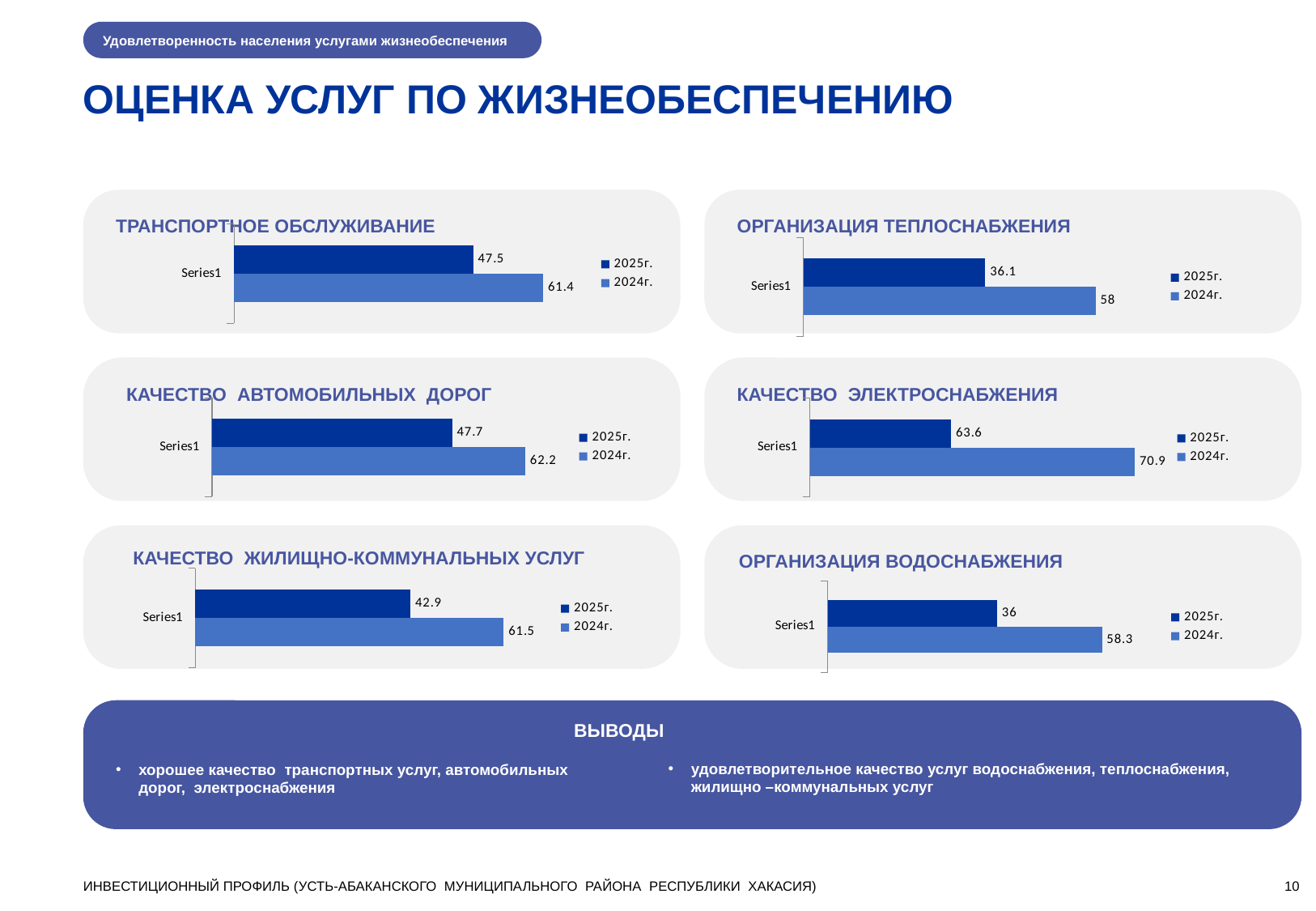
In the chart titled «КАЧЕСТВО ЭЛЕКТРОСНАБЖЕНИЯ», what is the value for 2024г.? 70.9 How many charts are shown on the slide? 6 In the chart titled «КАЧЕСТВО ЖИЛИЩНО-КОММУНАЛЬНЫХ УСЛУГ», which series has the larger value, 2025г. or 2024г.? 2024г. In the chart titled «ОРГАНИЗАЦИЯ ВОДОСНАБЖЕНИЯ», what is the difference between the 2024г. and 2025г. values? 22.3 In the chart titled «ТРАНСПОРТНОЕ ОБСЛУЖИВАНИЕ», what is the value for 2024г.? 61.4 In the chart titled «ОРГАНИЗАЦИЯ ВОДОСНАБЖЕНИЯ», what is the value for 2024г.? 58.3 In the chart titled «ОРГАНИЗАЦИЯ ТЕПЛОСНАБЖЕНИЯ», what is the difference between the 2024г. and 2025г. values? 21.9 In the chart titled «ТРАНСПОРТНОЕ ОБСЛУЖИВАНИЕ», what is the value for 2025г.? 47.5 How many series does the legend list in the chart titled «ОРГАНИЗАЦИЯ ТЕПЛОСНАБЖЕНИЯ»? 2 In the chart titled «ОРГАНИЗАЦИЯ ТЕПЛОСНАБЖЕНИЯ», what is the value for 2025г.? 36.1 In the chart titled «КАЧЕСТВО АВТОМОБИЛЬНЫХ ДОРОГ», what is the difference between the 2024г. and 2025г. values? 14.5 What kind of chart is the chart titled «КАЧЕСТВО ЭЛЕКТРОСНАБЖЕНИЯ»? Bar chart